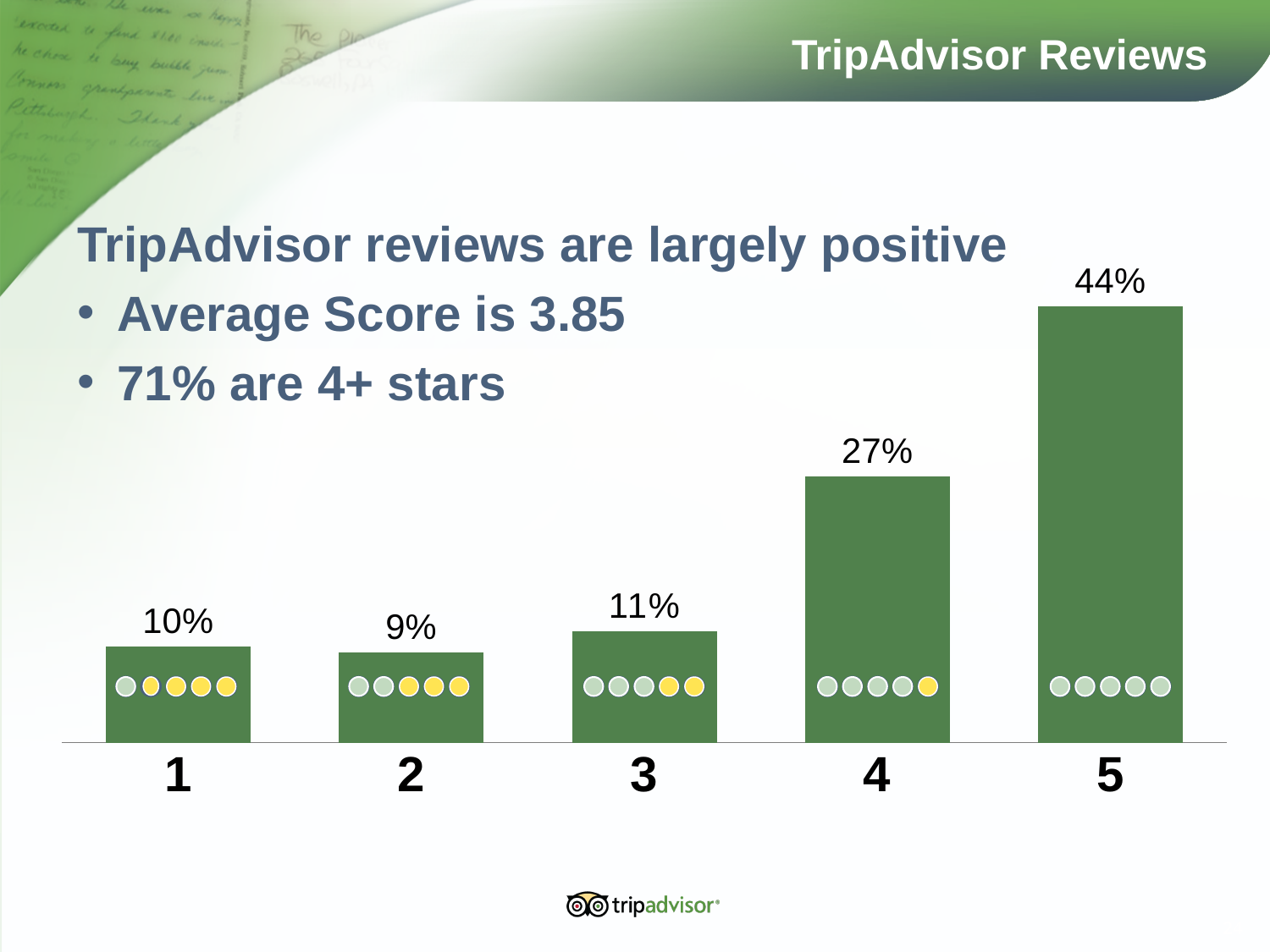
How many score categories are shown on the x axis? 5 Which score category has the lowest percentage of reviews? 2 What colour are the bars in the chart? green What kind of chart is used to show the review scores? bar chart What percentage of TripAdvisor reviews have a score of 5? 44% What is the combined percentage of reviews with scores of 4 and 5? 71% What is the difference between the percentage for score 5 and the percentage for score 4? 17% Which has a larger share of reviews, score 4 or score 1? 4 What percentage of reviews have a score of 2? 9% Which score category has the highest percentage of reviews? 5 What is the difference between the percentage for score 3 and the percentage for score 1? 1% What is the value shown for score 3? 11%